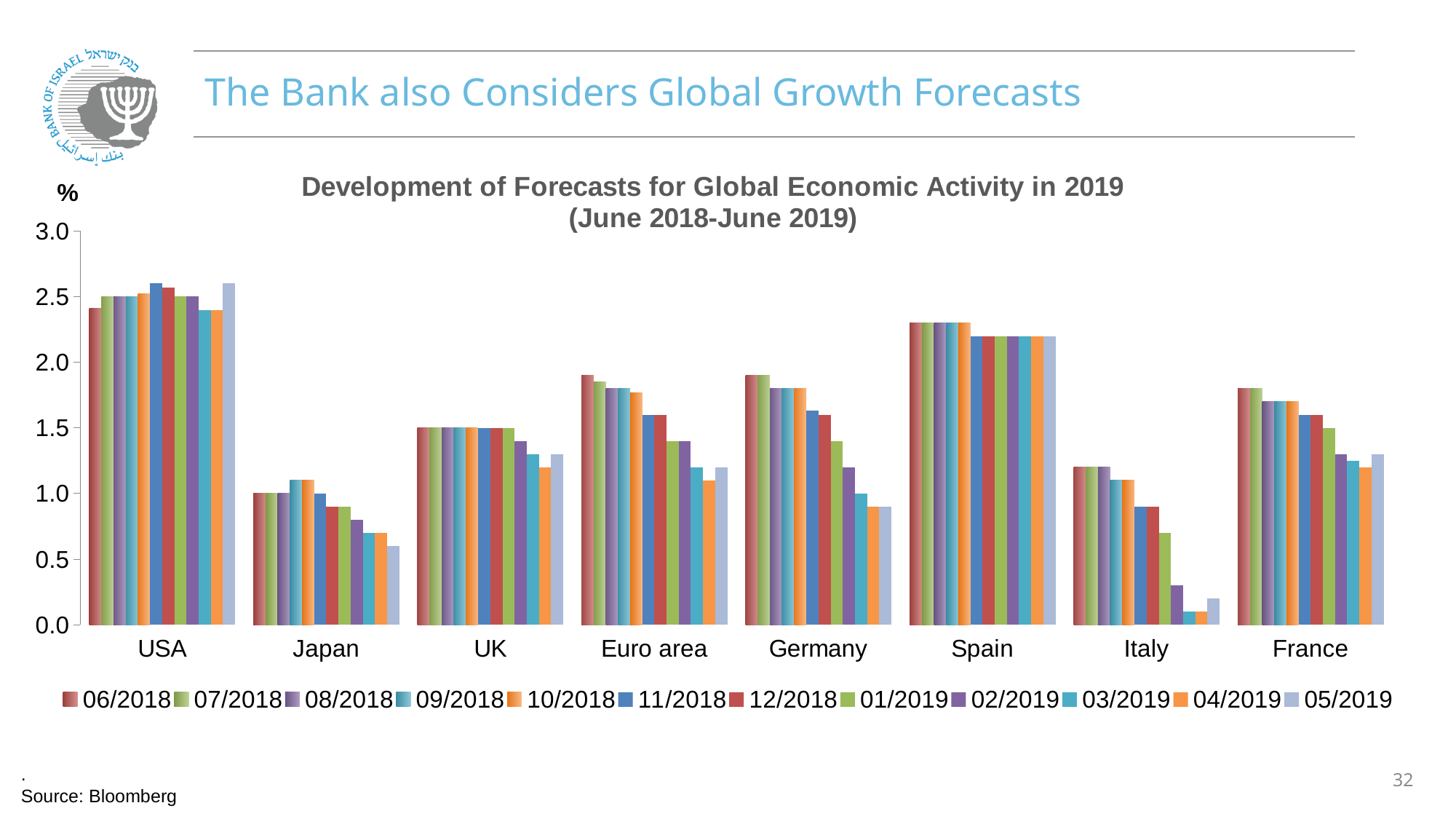
Is the 06/2018 forecast for France greater or less than 1.5? greater How many series does the legend list? 12 What is the title of the chart? Development of Forecasts for Global Economic Activity in 2019 (June 2018-June 2019) How many countries or regions are shown on the x axis? 8 Is the 06/2018 forecast for Spain greater or less than 2.0? greater Is the 05/2019 forecast for Japan greater or less than 1.0? less What kind of chart is shown on the slide? bar chart Which country or region has the highest 05/2019 forecast? USA Which country or region has the lowest 05/2019 forecast? Italy Which is larger, the 06/2018 forecast for Spain or for Germany? Spain Do the forecasts for Italy rise or fall from 06/2018 to 05/2019? fall